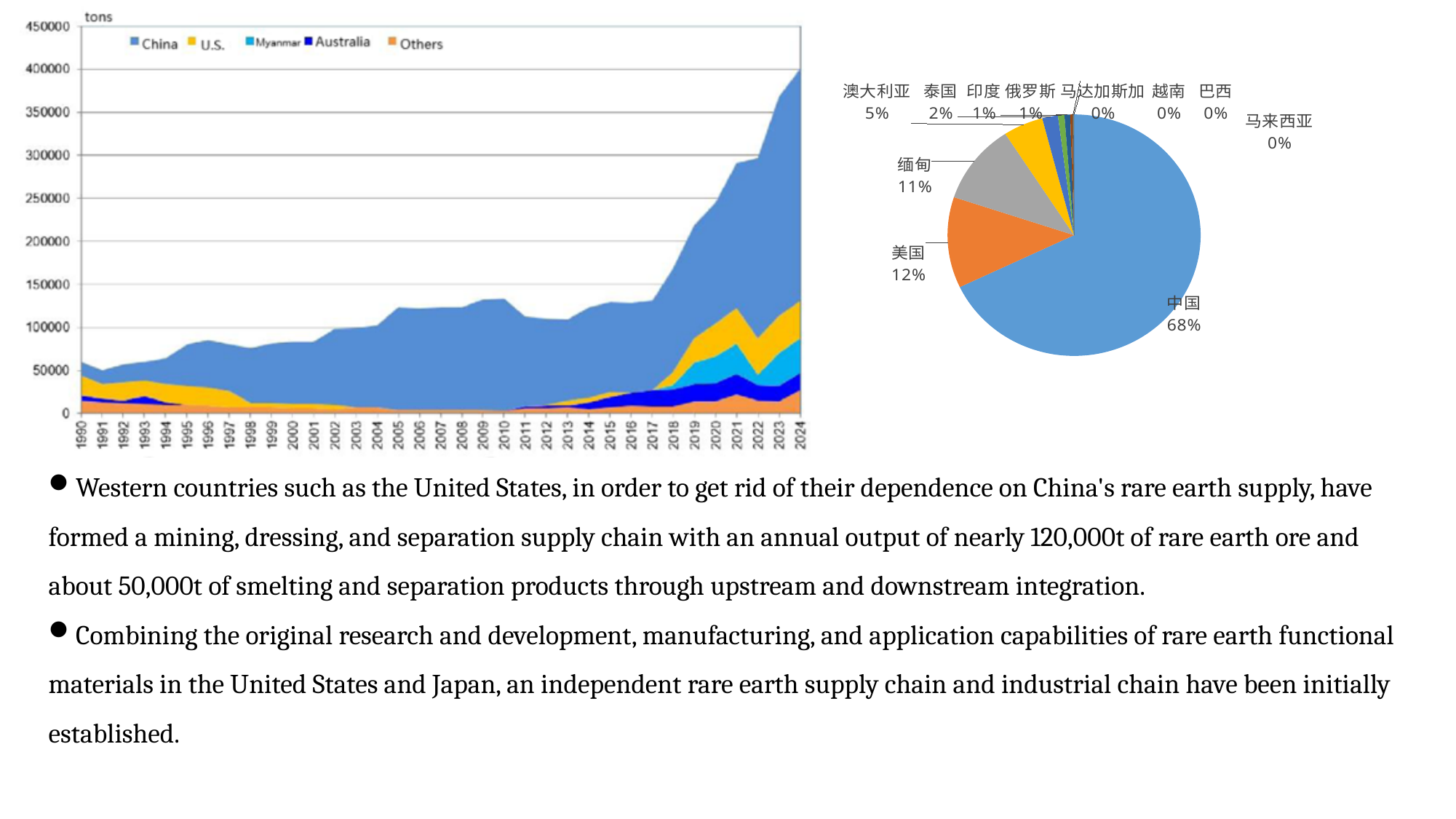
In the pie chart on the right, what share does 缅甸 have? 11% In the chart on the left, does the total production generally rise or fall from 1990 to 2024? rise In the pie chart on the right, what share does 澳大利亚 have? 5% In the pie chart on the right, which has the larger share, 美国 or 缅甸? 美国 In the pie chart on the right, what share does 美国 have? 12% In the chart on the left, is the total value for 2024 greater or less than 350000 tons? greater In the pie chart on the right, what share does 中国 have? 68% In the pie chart on the right, which slice is the largest? 中国 In the pie chart on the right, what is the difference in percentage points between 中国 and 美国? 56% How many slices are labelled in the pie chart on the right? 11 What kind of chart is the chart on the left? Stacked area chart How many series does the legend of the chart on the left list? 5